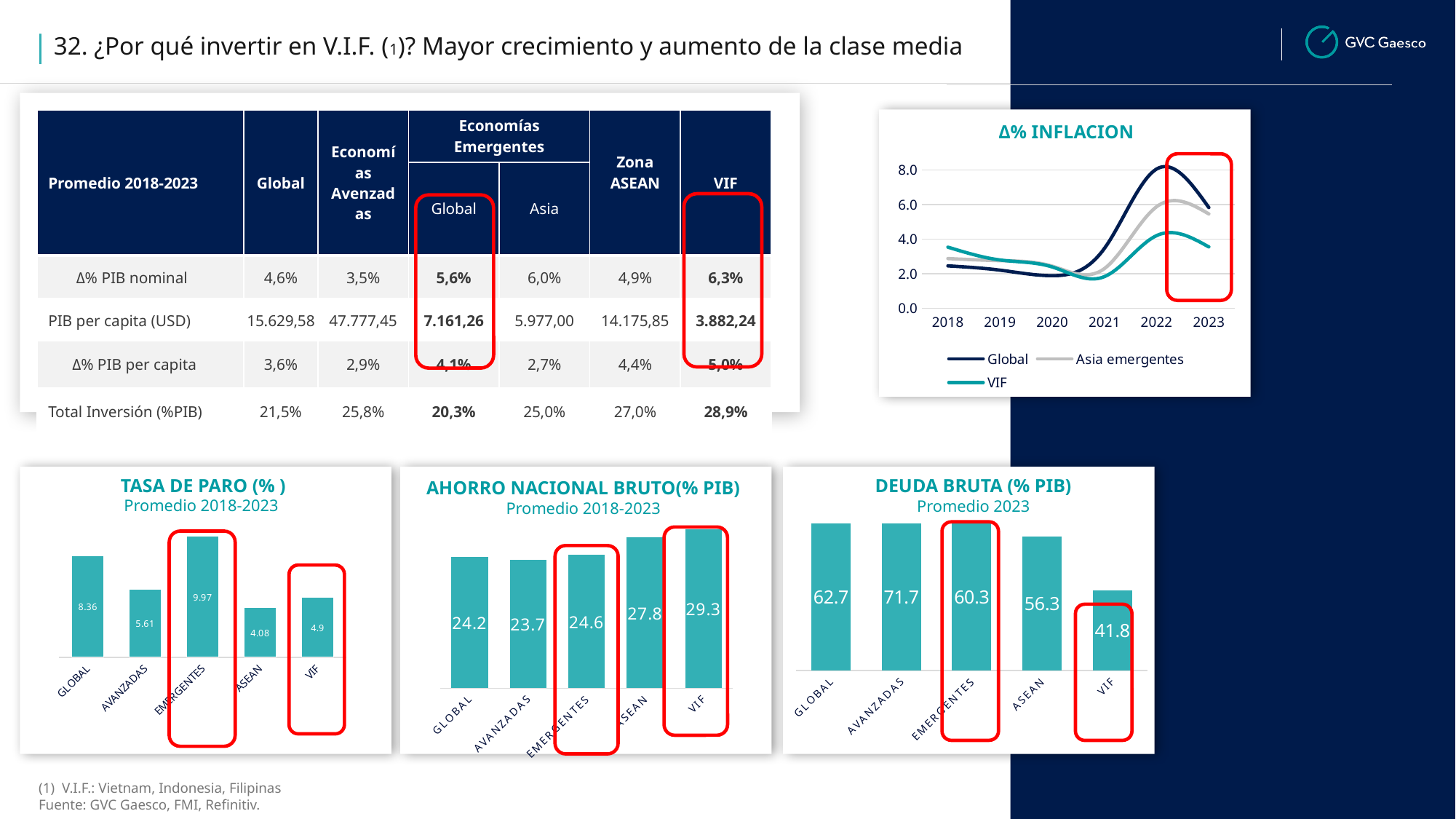
What kind of chart is the Δ% INFLACION chart? Line chart In the AHORRO NACIONAL BRUTO (% PIB) chart, how many categories are shown? 5 In the AHORRO NACIONAL BRUTO (% PIB) chart, what is the value for VIF? 29.3 In the TASA DE PARO (%) chart, what is the value for EMERGENTES? 9.97 In the TASA DE PARO (%) chart, what is the difference between GLOBAL and VIF? 3.46 In the AHORRO NACIONAL BRUTO (% PIB) chart, which category has the lowest value? AVANZADAS In the DEUDA BRUTA (% PIB) chart, which category has the highest value? AVANZADAS In the Δ% INFLACION chart, how many series does the legend list? 3 In the Δ% INFLACION chart, is the value for Global in 2022 greater or less than 6.0? greater In the DEUDA BRUTA (% PIB) chart, what is the value for ASEAN? 56.3 In the DEUDA BRUTA (% PIB) chart, what is the difference between GLOBAL and VIF? 20.9 In the TASA DE PARO (%) chart, which category has the lowest value? ASEAN